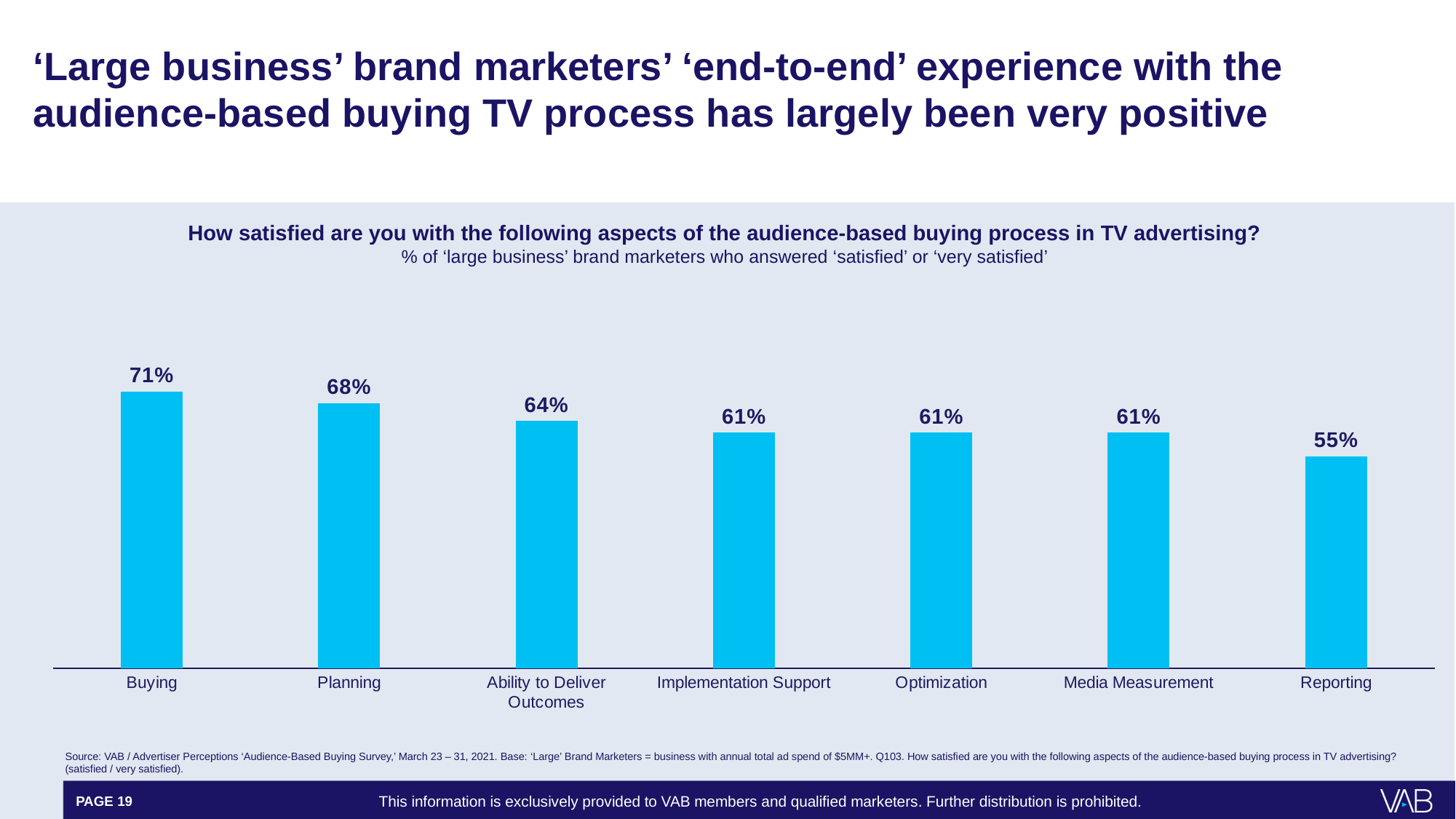
What is the difference between the values for Planning and Optimization? 7% Do the values rise or fall moving from left to right across the chart? Fall What kind of chart is shown on the slide? Bar chart How many aspects (categories) are shown in the chart? 7 What is the value shown for Ability to Deliver Outcomes? 64% Which is larger, the value for Ability to Deliver Outcomes or the value for Media Measurement? Ability to Deliver Outcomes What is the difference between the values for Buying and Reporting? 16% What percentage of 'large business' brand marketers are satisfied or very satisfied with Buying? 71% What is the value shown for Reporting? 55% Which aspect has the lowest satisfaction percentage? Reporting What is the value shown for Planning? 68% Which aspect has the highest satisfaction percentage? Buying